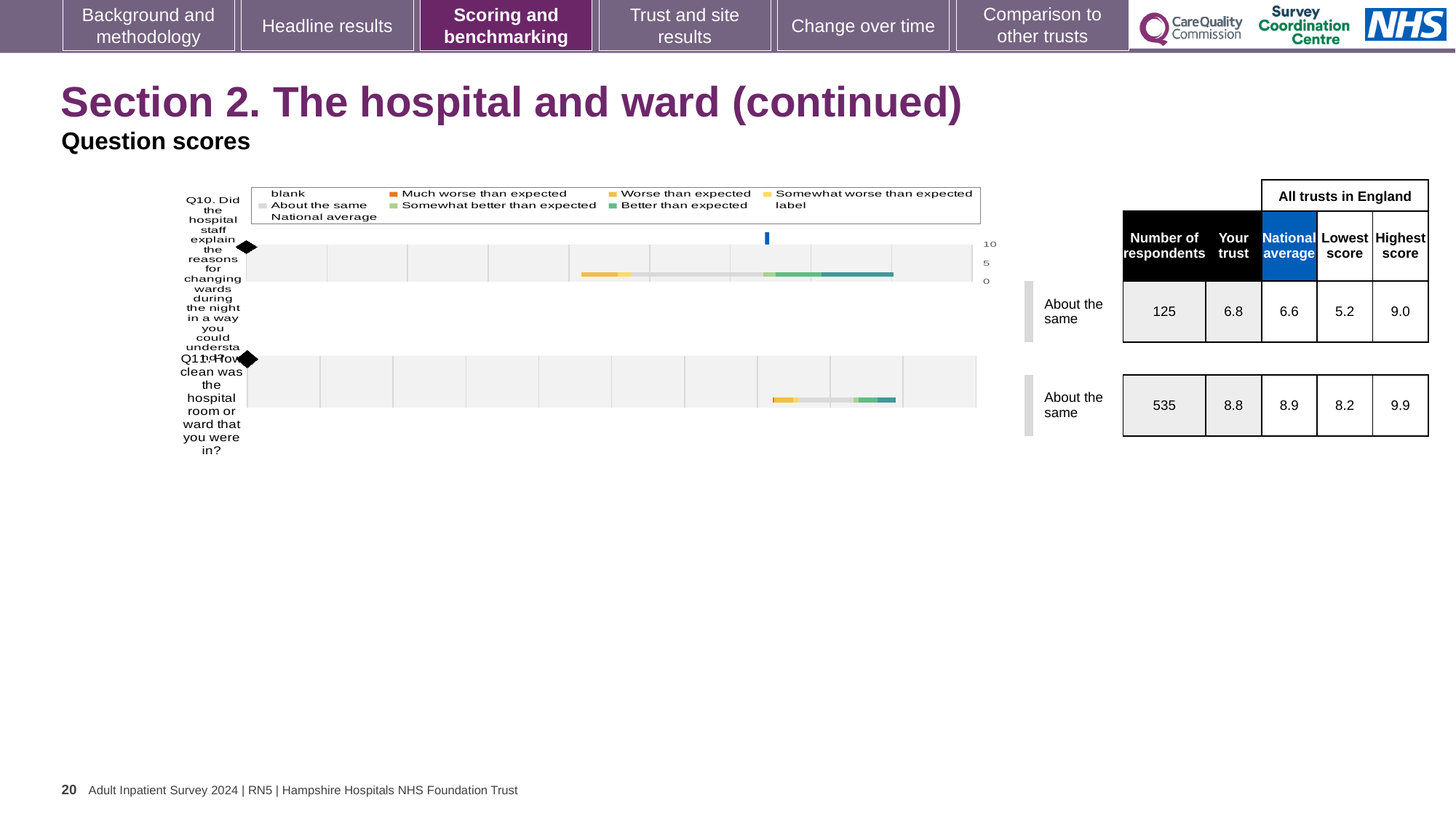
What is the highest score among all trusts in England for Q11? 9.9 What is the 'Your trust' score for Q10 (explaining reasons for changing wards during the night)? 6.8 How many respondents answered Q10? 125 How many survey questions are plotted on the chart? 2 What is the maximum value shown on the chart's score axis? 10 What is the difference between the highest score and the lowest score for Q11? 1.7 What benchmarking category is shown for Q11? About the same What is the difference between the national average and the lowest score for Q10? 1.4 For Q10, which is larger: the 'Your trust' score or the national average? Your trust What is the national average score for Q11 (how clean was the hospital room or ward)? 8.9 What kind of chart is used to show the question scores for Q10 and Q11? Bar chart Which question has the higher 'Your trust' score, Q10 or Q11? Q11